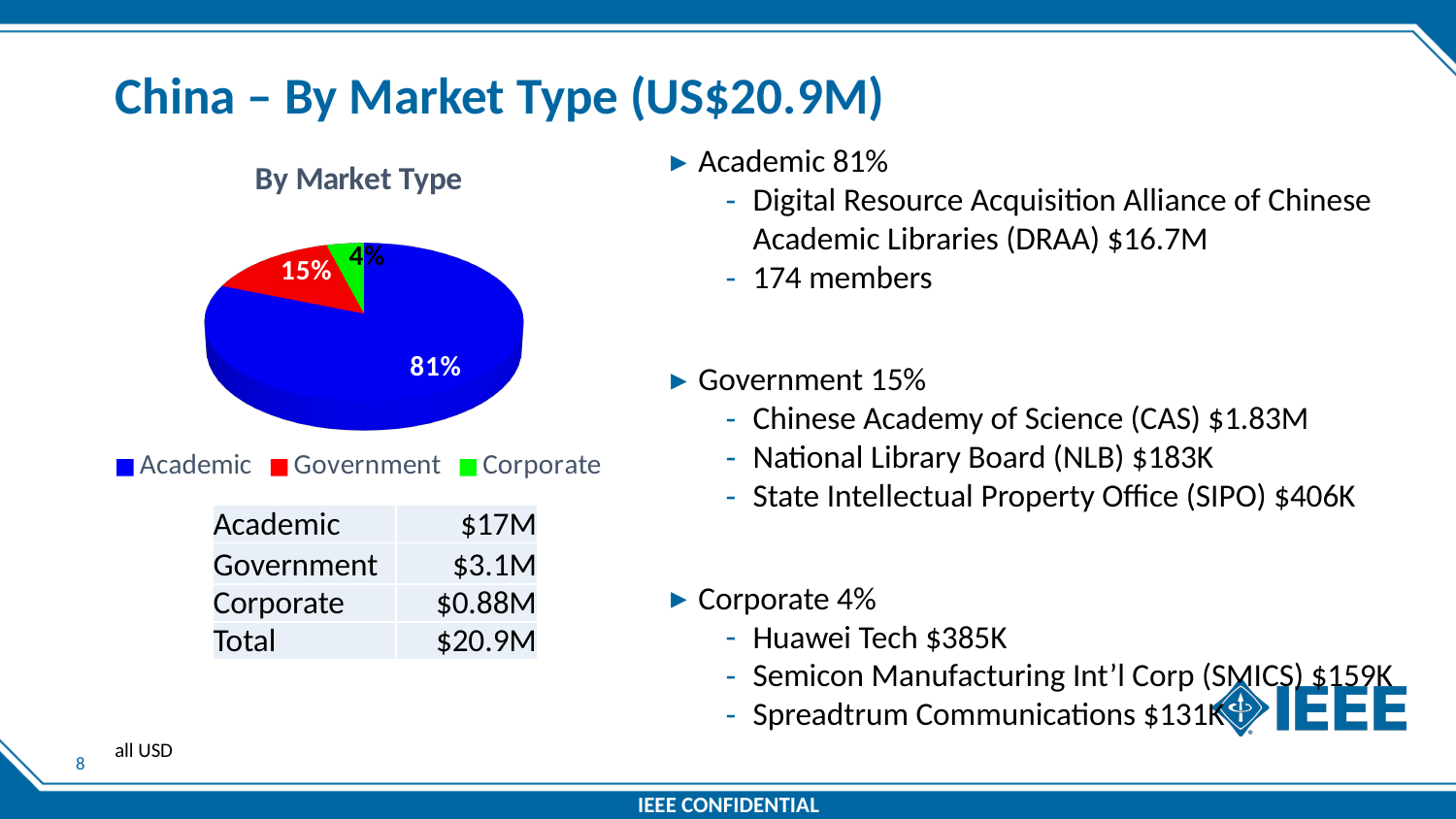
Which slice is larger, Government or Corporate? Government How many entries does the legend list? 3 What kind of chart is shown on the slide? pie chart Which category has the largest slice of the pie? Academic Which category has the smallest slice of the pie? Corporate What is the chart's title? By Market Type What share of the pie does Corporate hold? 4% What colour is the Government slice in the pie chart? red What share of the pie does Academic hold? 81% What is the difference in percentage points between the Academic and Government slices? 66 What share of the pie does Government hold? 15% How many categories does the pie chart show? 3